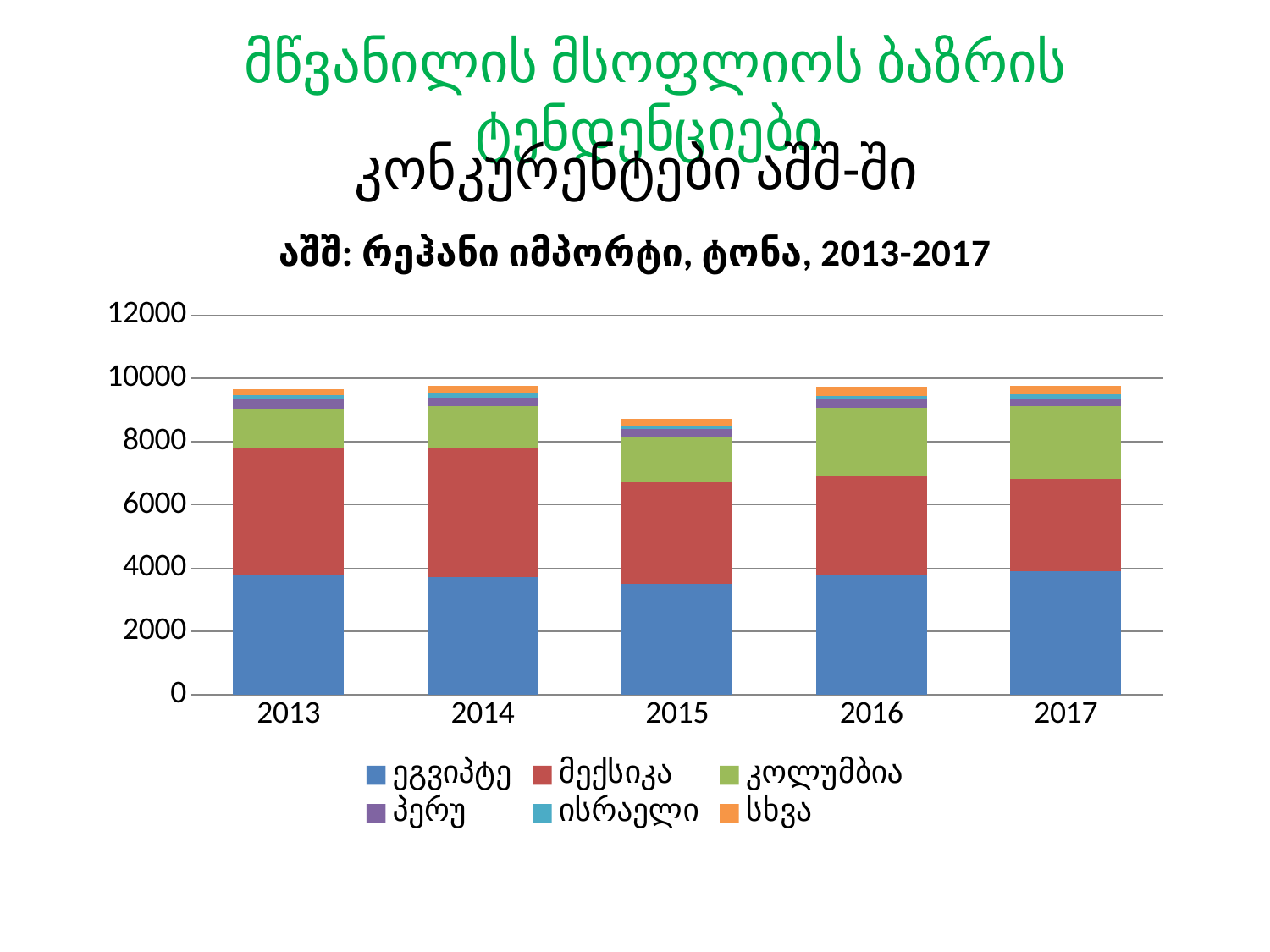
Is the total stacked bar for 2015 greater or less than 8000? greater Which series forms the bottom segment of each stacked bar? ეგვიპტე How many series does the chart legend list? 6 Which total stacked bar is larger, 2015 or 2016? 2016 What kind of chart is shown on the slide? stacked bar chart Which year has the lowest total stacked bar? 2015 How many years are shown on the x axis of the chart? 5 Which year has the larger კოლუმბია segment, 2013 or 2017? 2017 What is the title of the chart? აშშ: რეჰანი იმპორტი, ტონა, 2013-2017 Is the total stacked bar for 2014 greater or less than 10000? less Is the ეგვიპტე segment for 2013 greater or less than 4000? less